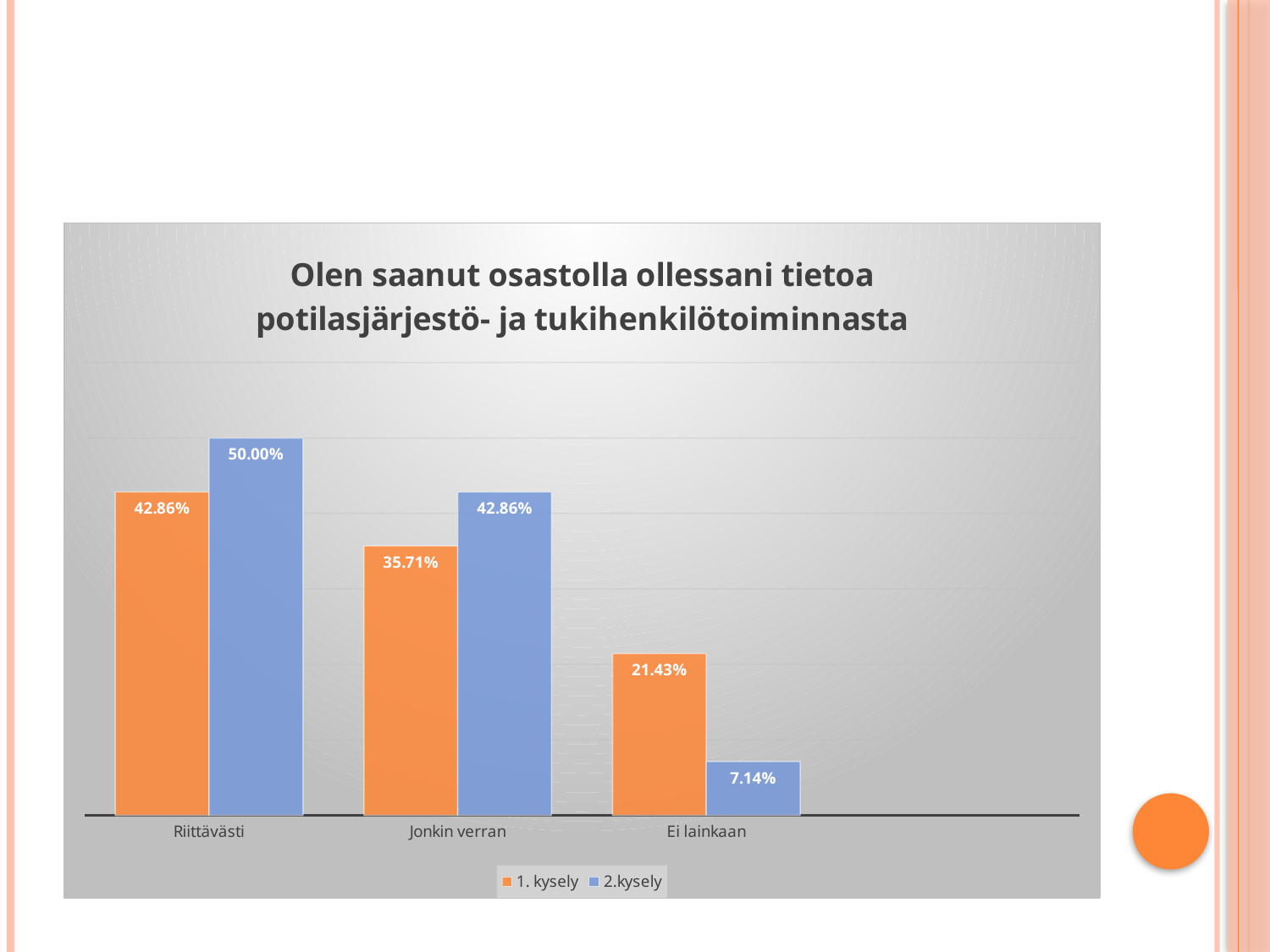
What is the value for "1. kysely" in the "Jonkin verran" category? 35.71% What kind of chart is shown on the slide? Bar chart How many series does the legend list? 2 What is the difference between the "2.kysely" and "1. kysely" values in the "Riittävästi" category? 7.14% What is the value for "1. kysely" in the "Riittävästi" category? 42.86% What is the value for "2.kysely" in the "Ei lainkaan" category? 7.14% What is the difference between the "1. kysely" and "2.kysely" values in the "Ei lainkaan" category? 14.29% How many categories are shown on the x axis? 3 In the "Jonkin verran" category, which series has the larger value, "1. kysely" or "2.kysely"? 2.kysely Which category has the highest value for "2.kysely"? Riittävästi What colour are the bars for the "2.kysely" series? Blue Which category has the lowest value for "1. kysely"? Ei lainkaan